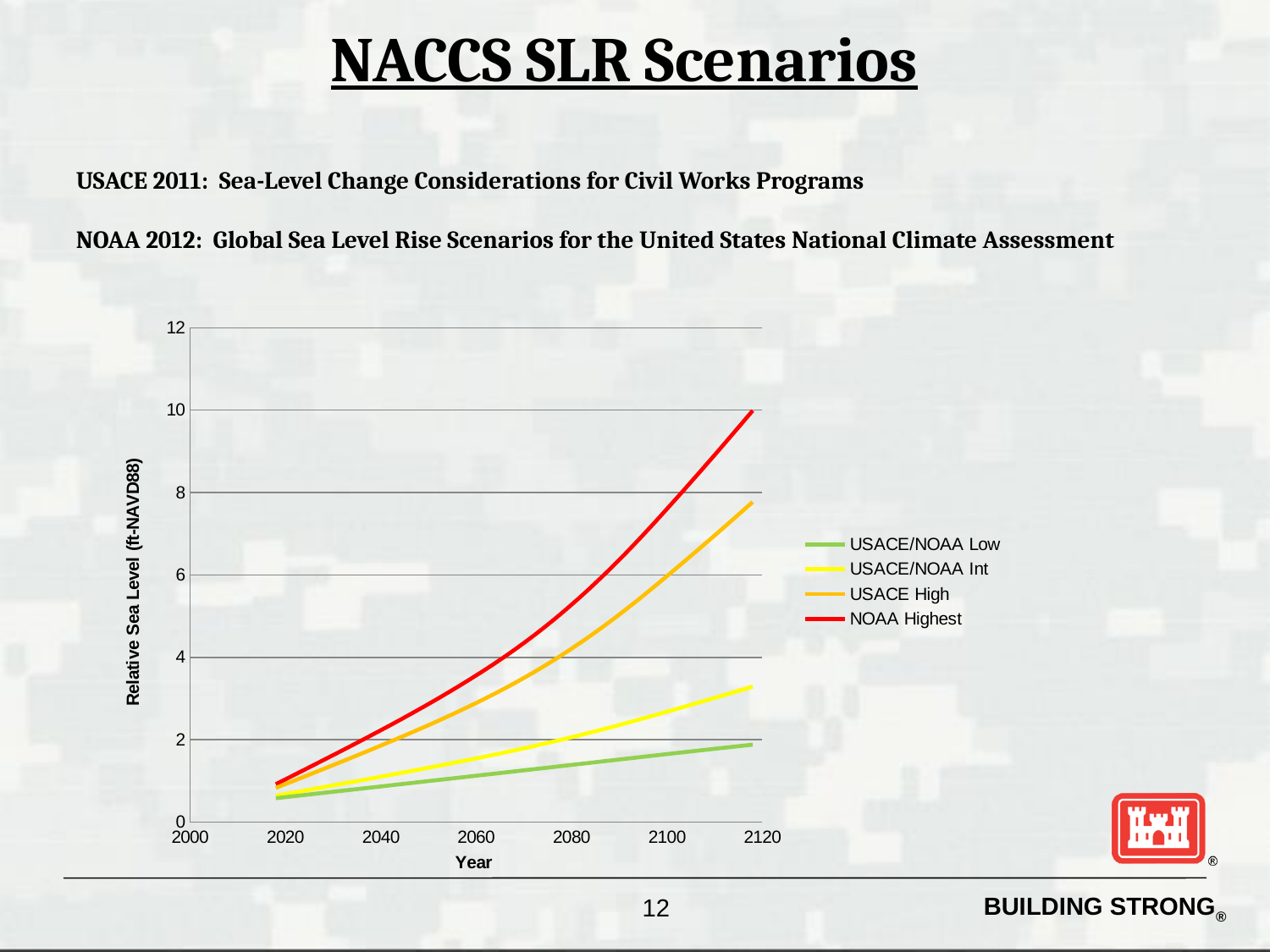
How many series does the legend list? 4 Is the value for NOAA Highest at 2080 greater or less than 4? greater Do the relative sea level values for NOAA Highest rise or fall as the year increases? rise Which series is plotted in red? NOAA Highest What kind of chart is shown on the slide? line chart Which series has the highest relative sea level at the right end of the chart (around 2120)? NOAA Highest Is the value for USACE/NOAA Int at 2120 greater or less than 2? greater At 2100, which series has the larger value, NOAA Highest or USACE High? NOAA Highest Is the value for USACE High at 2120 greater or less than 8? less Which series has the lowest relative sea level at the right end of the chart (around 2120)? USACE/NOAA Low What is the label of the vertical axis? Relative Sea Level (ft-NAVD88)